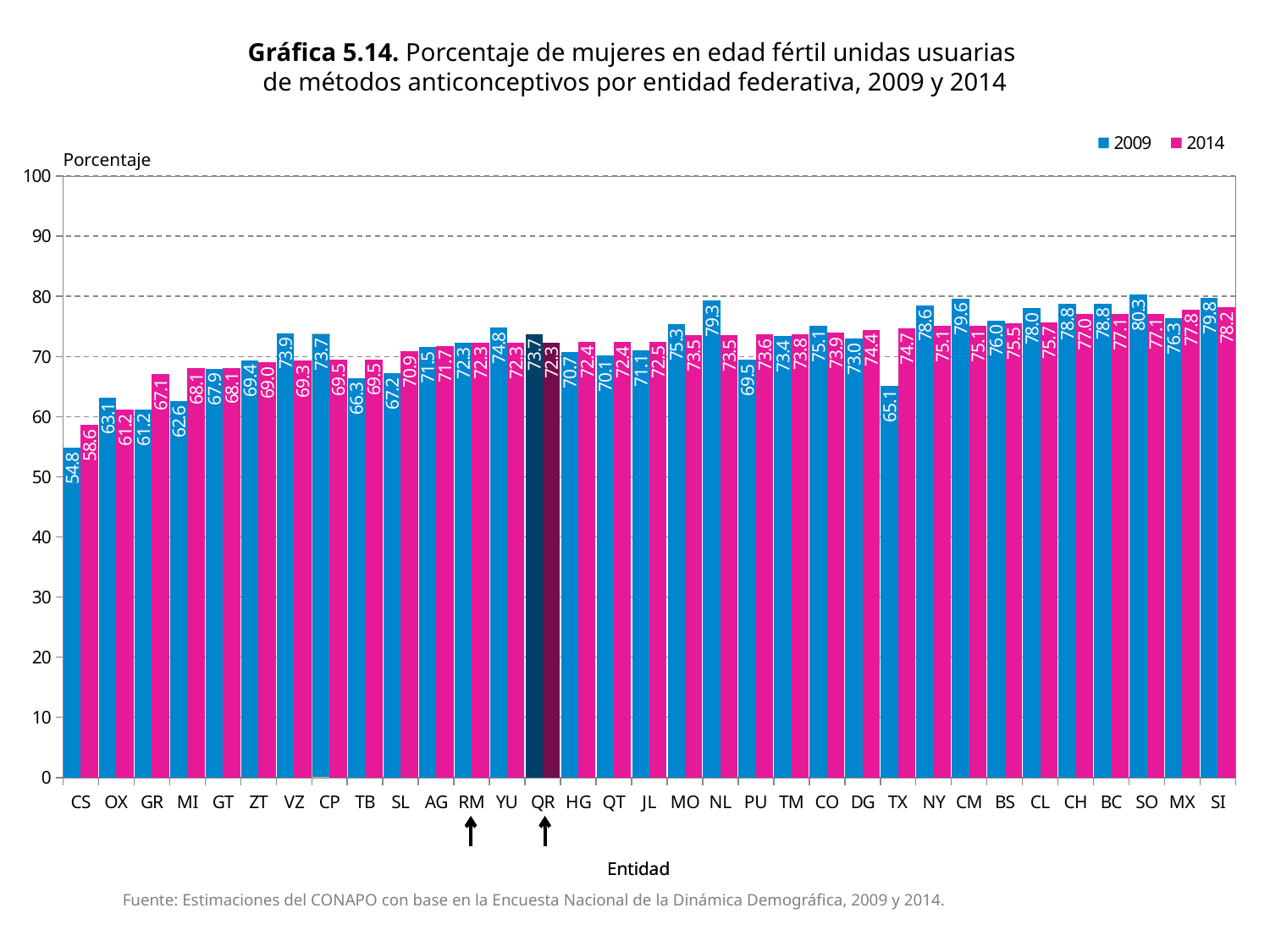
What is the 2014 value for TX? 74.7 What is the 2009 value for NL? 79.3 How many series does the legend list? 2 What is the difference between the 2009 and 2014 values for TX? 9.6 Which entity has the lowest 2014 value? CS What kind of chart is this? bar chart Do the 2014 values generally rise or fall from left to right along the x axis? rise What is the 2009 value for CS? 54.8 Is the 2009 value for CS greater or less than 60? less How many entities are shown on the x axis? 33 Which entity has the highest 2009 value? SO For CM, which is larger, the 2009 value or the 2014 value? 2009